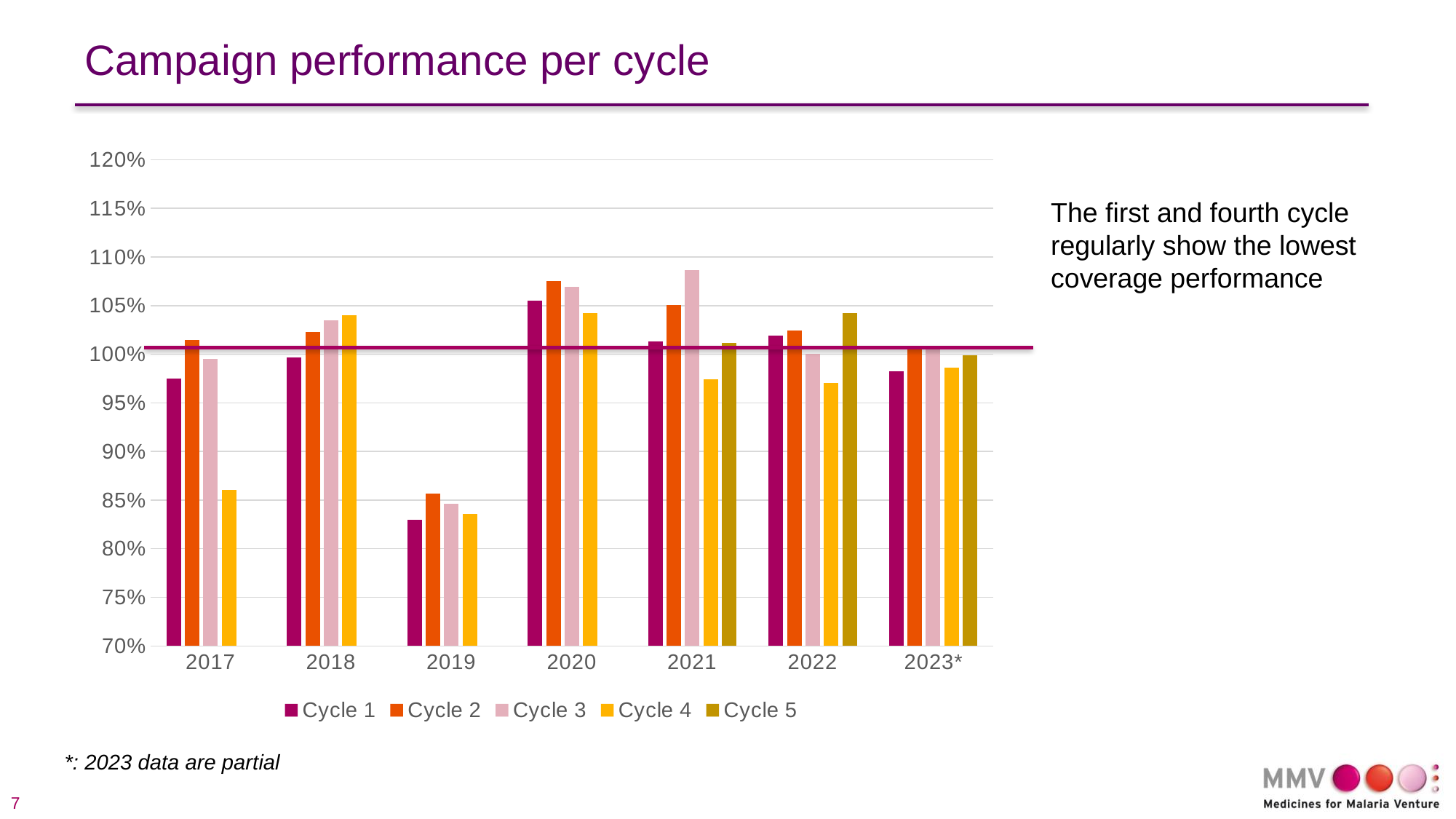
Is the value for Cycle 2 in 2020 greater or less than 105%? greater What is the title of the chart? Campaign performance per cycle What kind of chart is shown on the slide? bar chart Which cycle has the highest value in 2021? Cycle 3 Is the value for Cycle 3 in 2021 greater or less than 105%? greater How many series does the legend list? 5 How many years are shown on the x axis? 7 Is the value for Cycle 1 in 2019 greater or less than 85%? less Which cycle has the lowest value in 2017? Cycle 4 Which is larger, the Cycle 1 value in 2019 or the Cycle 1 value in 2020? 2020 In which year is the Cycle 1 value lowest? 2019